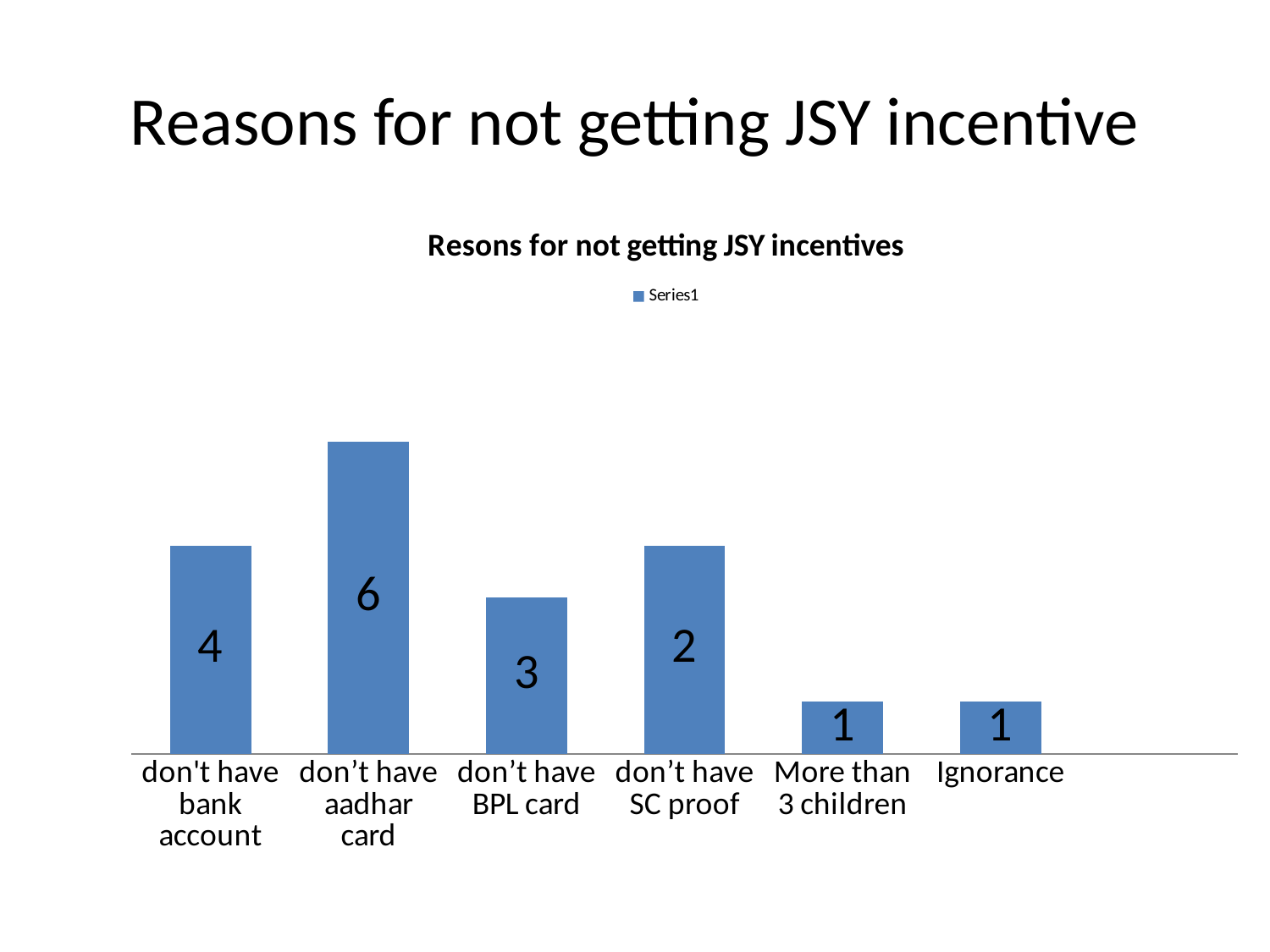
What is the difference between the values for "don't have BPL card" and "Ignorance"? 2 What is the difference between the values for "don't have aadhar card" and "don't have bank account"? 2 What is the value for "don't have BPL card"? 3 What kind of chart is shown? bar chart How many series does the legend list? 1 What is the value for "don't have aadhar card"? 6 Which is larger, the value for "don't have bank account" or "don't have BPL card"? don't have bank account What is the value for "Ignorance"? 1 What is the value for "don't have bank account"? 4 What is the value for "More than 3 children"? 1 How many reasons (categories) are shown on the x axis? 6 Which reason has the highest value? don't have aadhar card